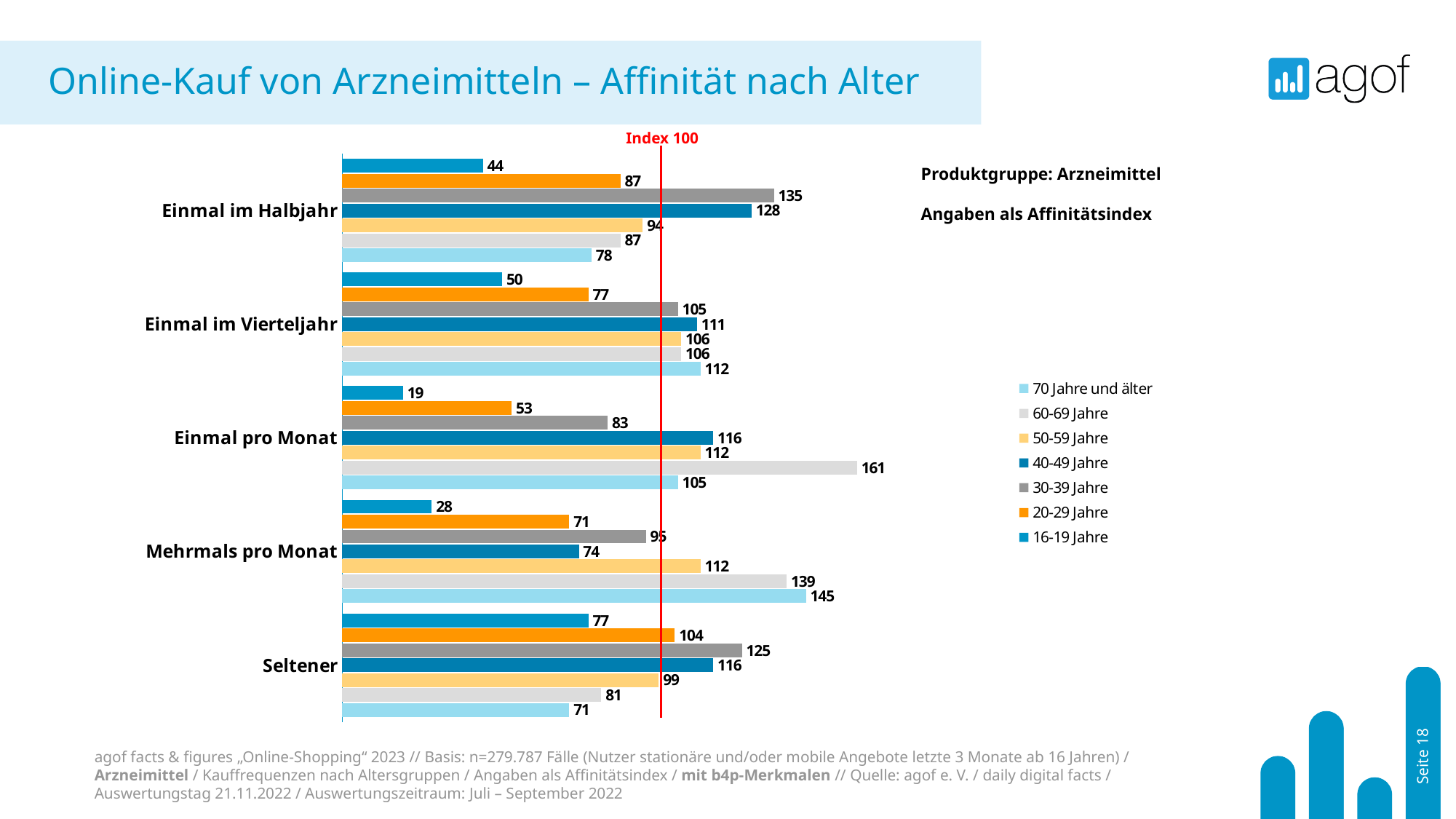
Which age group has the highest affinity index in the category "Seltener"? 30-39 Jahre What is the affinity index for 30-39 Jahre in the category "Einmal im Halbjahr"? 135 Which age group has the lowest affinity index in the category "Einmal im Vierteljahr"? 16-19 Jahre What is the affinity index for 60-69 Jahre in the category "Einmal pro Monat"? 161 In the category "Einmal im Halbjahr", which is larger: the value for 40-49 Jahre or the value for 50-59 Jahre? 40-49 Jahre What is the affinity index for 16-19 Jahre in the category "Einmal pro Monat"? 19 How many age groups does the legend list? 7 What is the affinity index for 70 Jahre und älter in the category "Mehrmals pro Monat"? 145 How many purchase-frequency categories are shown on the chart? 5 What type of chart is shown on the slide? Bar chart What value does the red vertical reference line on the chart mark? Index 100 What is the difference between the affinity index of 70 Jahre und älter and 16-19 Jahre in the category "Mehrmals pro Monat"? 117